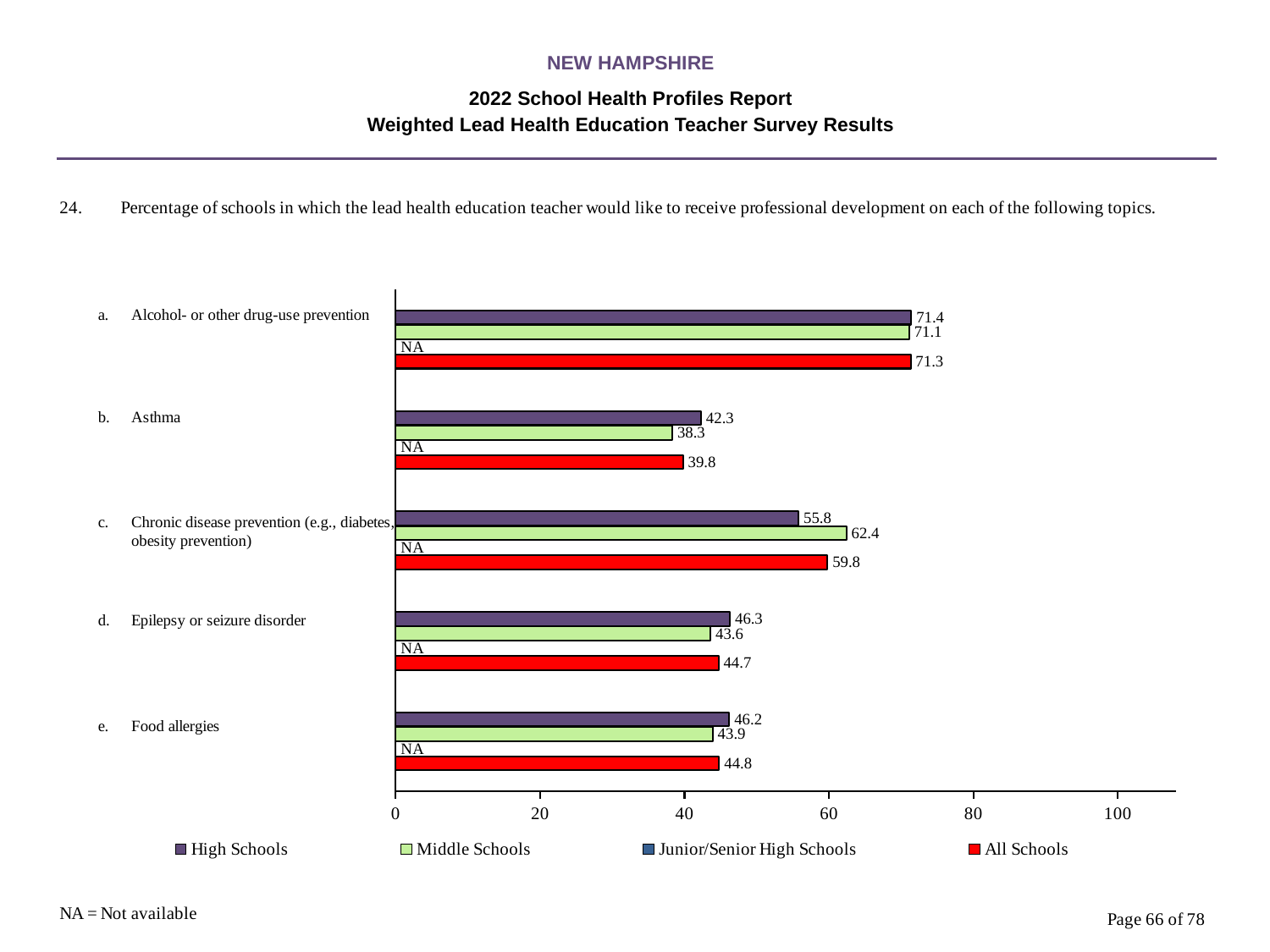
Is the All Schools value for Epilepsy or seizure disorder greater or less than 40? greater How many topics are shown in the chart? 5 What kind of chart is shown on the slide? bar chart Which topic has the lowest Middle Schools value? Asthma What is the High Schools value for Alcohol- or other drug-use prevention? 71.4 What is the All Schools value for Asthma? 39.8 How many series does the legend list? 4 For Chronic disease prevention, which is larger: the High Schools value or the Middle Schools value? Middle Schools What is the difference between the High Schools and Middle Schools values for Asthma? 4.0 Which topic has the highest All Schools value? Alcohol- or other drug-use prevention What is the Middle Schools value for Food allergies? 43.9 What is the Middle Schools value for Chronic disease prevention (e.g., diabetes, obesity prevention)? 62.4